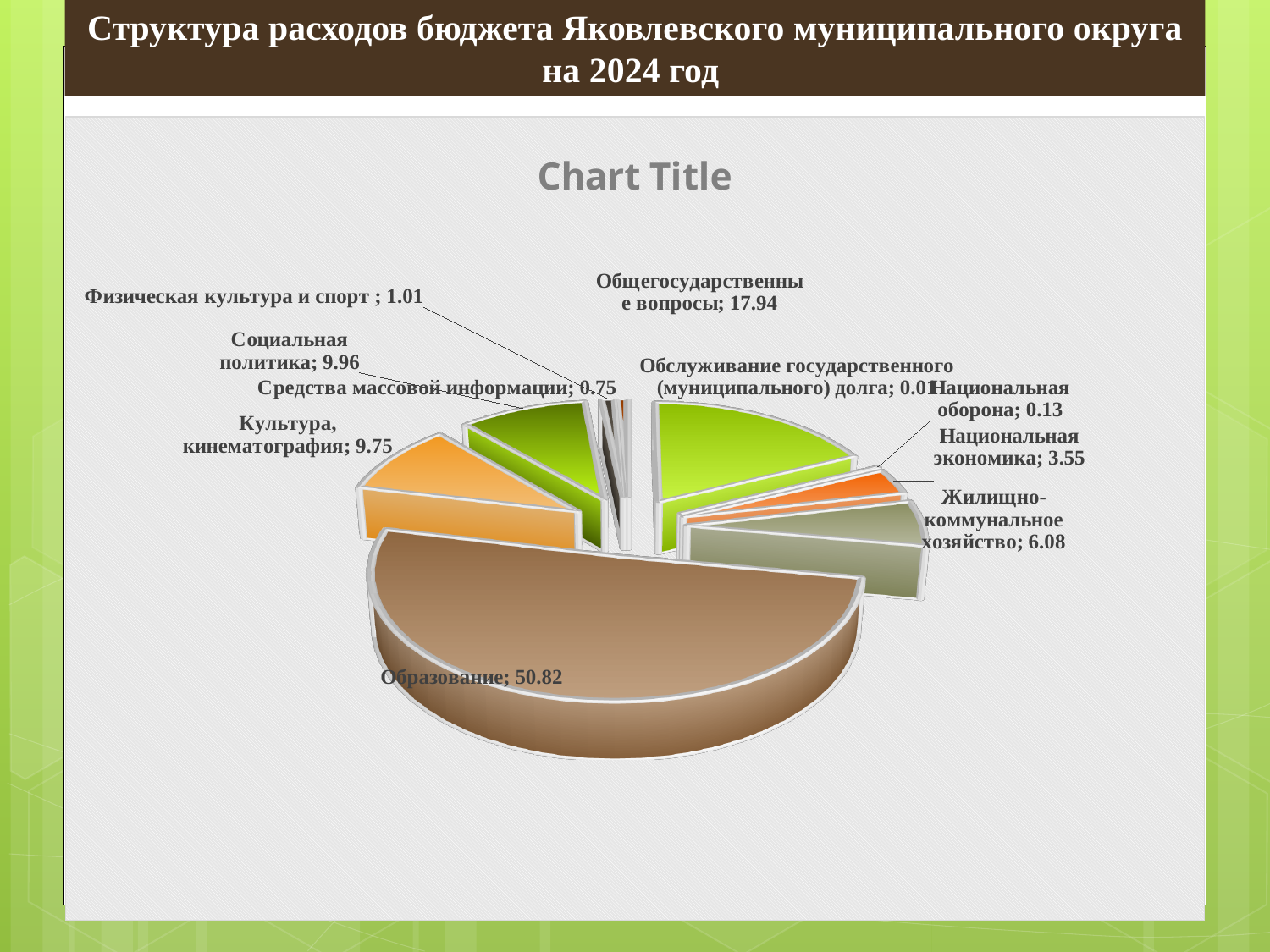
Which category has the largest slice of the pie? Образование What is the difference between the values for Образование and Общегосударственные вопросы? 32.88 Which category has the smallest value? Обслуживание государственного (муниципального) долга What is the value for Образование? 50.82 What is the value for Национальная экономика? 3.55 How many categories are shown in the pie chart? 10 Which is larger, the value for Физическая культура и спорт or the value for Средства массовой информации? Физическая культура и спорт What is the title printed above the pie chart? Chart Title What type of chart is shown on the slide? pie chart What is the value for Общегосударственные вопросы? 17.94 What is the difference between the values for Социальная политика and Культура, кинематография? 0.21 What is the value for Жилищно-коммунальное хозяйство? 6.08